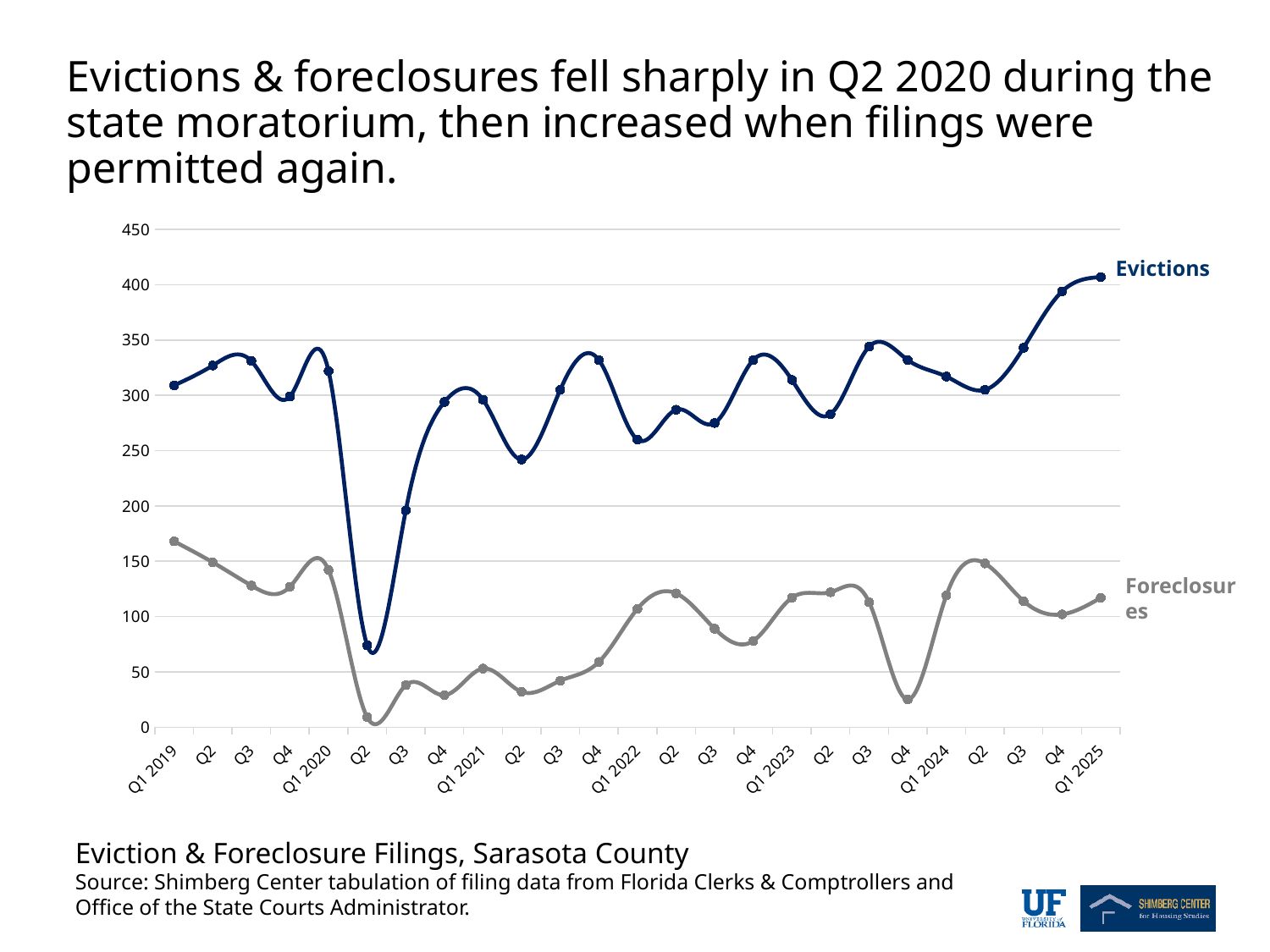
Is the Foreclosures value for Q4 2023 greater or less than 50? less In which quarter is the Evictions series at its lowest? Q2 2020 Which series has the higher value in Q1 2019, Evictions or Foreclosures? Evictions Is the Evictions value for Q2 2020 greater or less than 100? less How many quarterly points are plotted along the x axis for each series? 25 Is the Evictions value for Q1 2025 greater or less than 400? greater What kind of chart is shown on the slide? line chart Do Evictions rise or fall from Q2 2024 to Q1 2025? rise How many series are plotted on the chart? 2 What is the title of the chart given below the plot? Eviction & Foreclosure Filings, Sarasota County In which quarter is the Foreclosures series at its lowest? Q2 2020